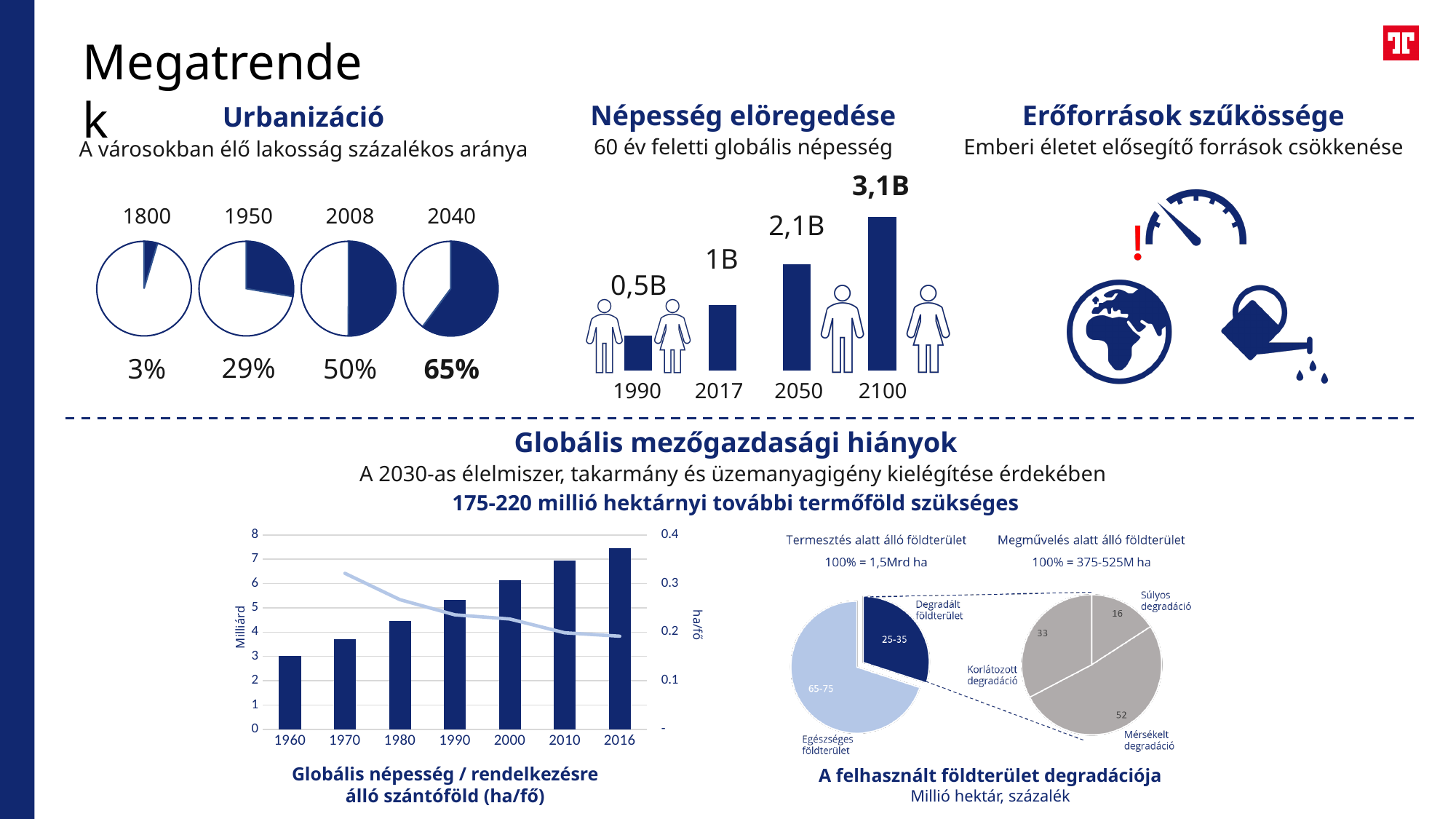
In the Népesség elöregedése bar chart, which year has the lowest value? 1990 In the Urbanizáció chart, what percentage is shown for 2008? 50% In the Urbanizáció chart, how many years (pie charts) are shown? 4 In the bottom-left chart (Globális népesség / rendelkezésre álló szántóföld), how many years are shown on the x axis? 7 In the Népesség elöregedése bar chart, do the values rise or fall from 1990 to 2100? rise In the Népesség elöregedése bar chart, which year has the highest value? 2100 In the bottom-left chart (Globális népesség / rendelkezésre álló szántóföld), is the bar for 2016 greater or less than 7? greater In the bottom-right pie chart (A felhasznált földterület degradációja), what value is shown for Súlyos degradáció? 16 In the Urbanizáció chart, what percentage is shown for 1800? 3% In the bottom-left chart (Globális népesség / rendelkezésre álló szántóföld), does the line (ha/fő) rise or fall from 1970 to 2016? fall In the Népesség elöregedése bar chart, what is the value for 2050? 2,1B In the bottom-right pie chart (A felhasznált földterület degradációja), which degradation category has the largest slice? Mérsékelt degradáció